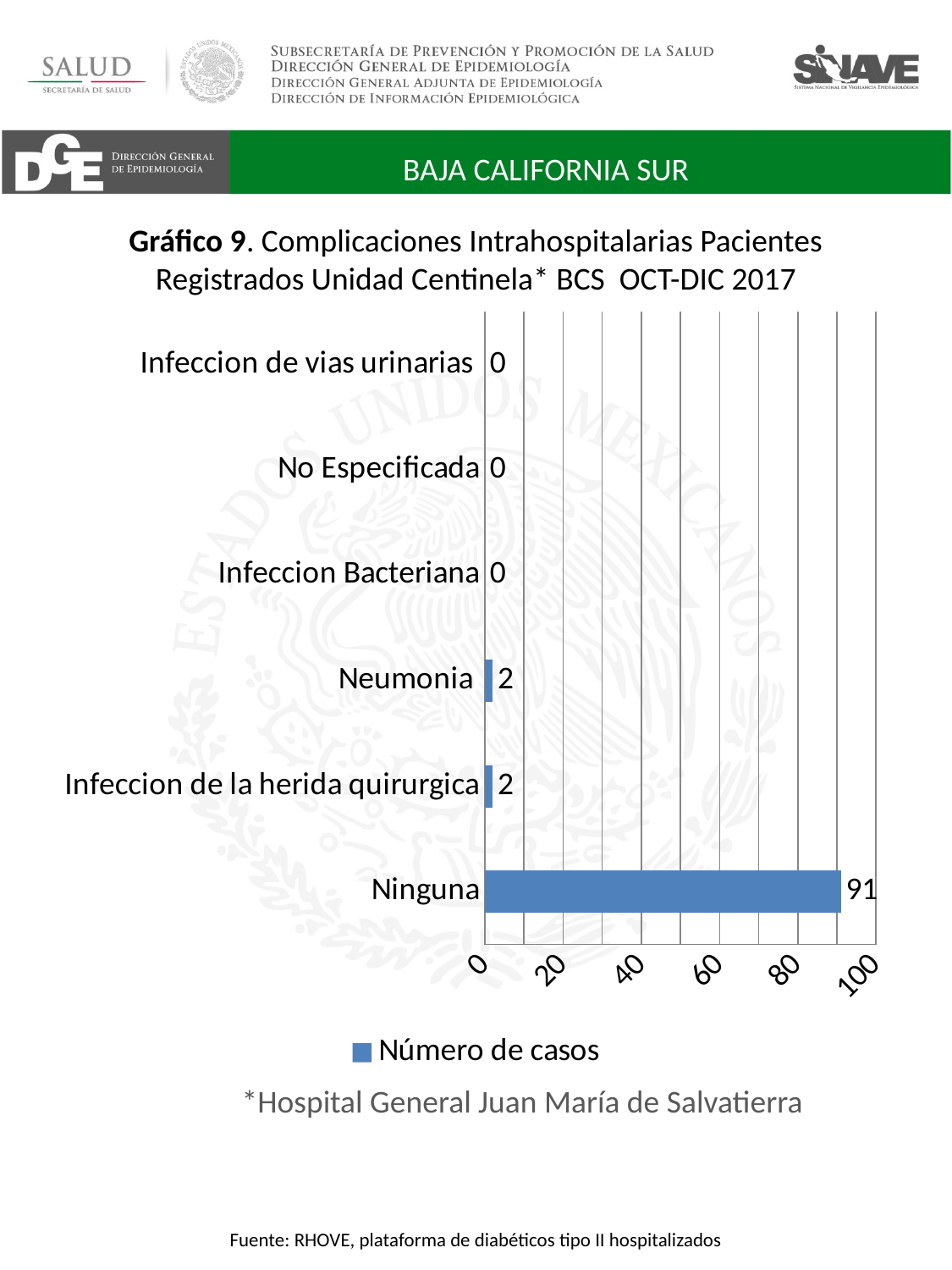
What is the number of cases for Infeccion de la herida quirurgica? 2 Which category has the highest number of cases? Ninguna What is the legend entry of the chart? Número de casos What is the number of cases for Ninguna? 91 Which has more cases, Ninguna or Infeccion de la herida quirurgica? Ninguna What is the number of cases for Infeccion de vias urinarias? 0 What kind of chart is shown on the slide? Bar chart What is the number of cases for Neumonia? 2 What is the difference in number of cases between Ninguna and Neumonia? 89 How many series does the legend list? 1 How many categories are shown on the chart? 6 Is the value for Ninguna greater or less than 80? greater